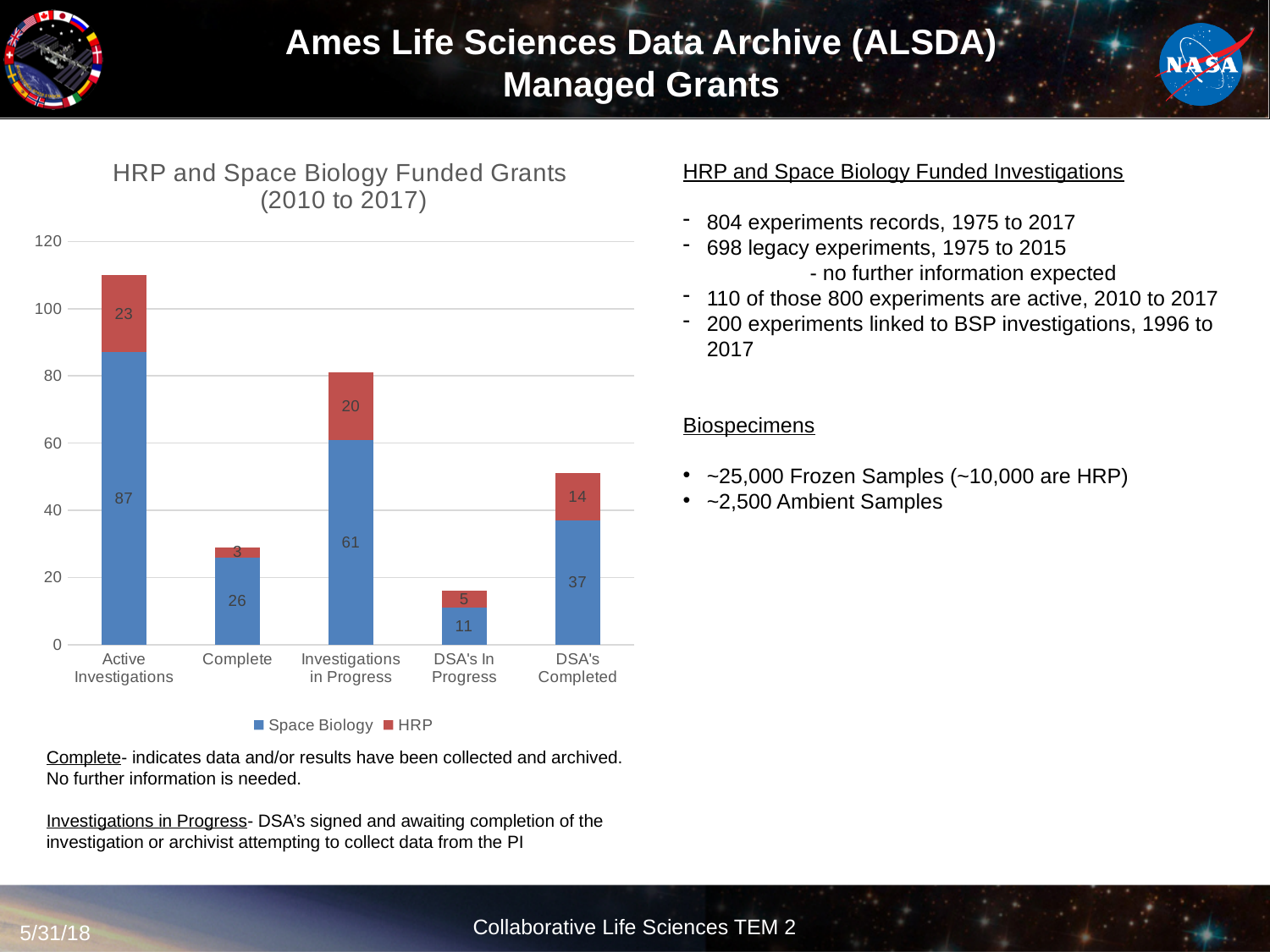
How many series does the legend list? 2 What is the total of the stacked bar for DSA's In Progress? 16 Which is larger, the HRP value for Active Investigations or the HRP value for DSA's Completed? Active Investigations What is the HRP value for Investigations in Progress? 20 Which category has the lowest HRP value? Complete How many categories are shown on the x axis? 5 Which category has the highest Space Biology value? Active Investigations What is the Space Biology value for Active Investigations? 87 What is the total of the stacked bar for Active Investigations? 110 What is the difference between the Space Biology values for Investigations in Progress and Complete? 35 What is the HRP value for DSA's Completed? 14 What kind of chart is shown on the slide? Stacked bar chart